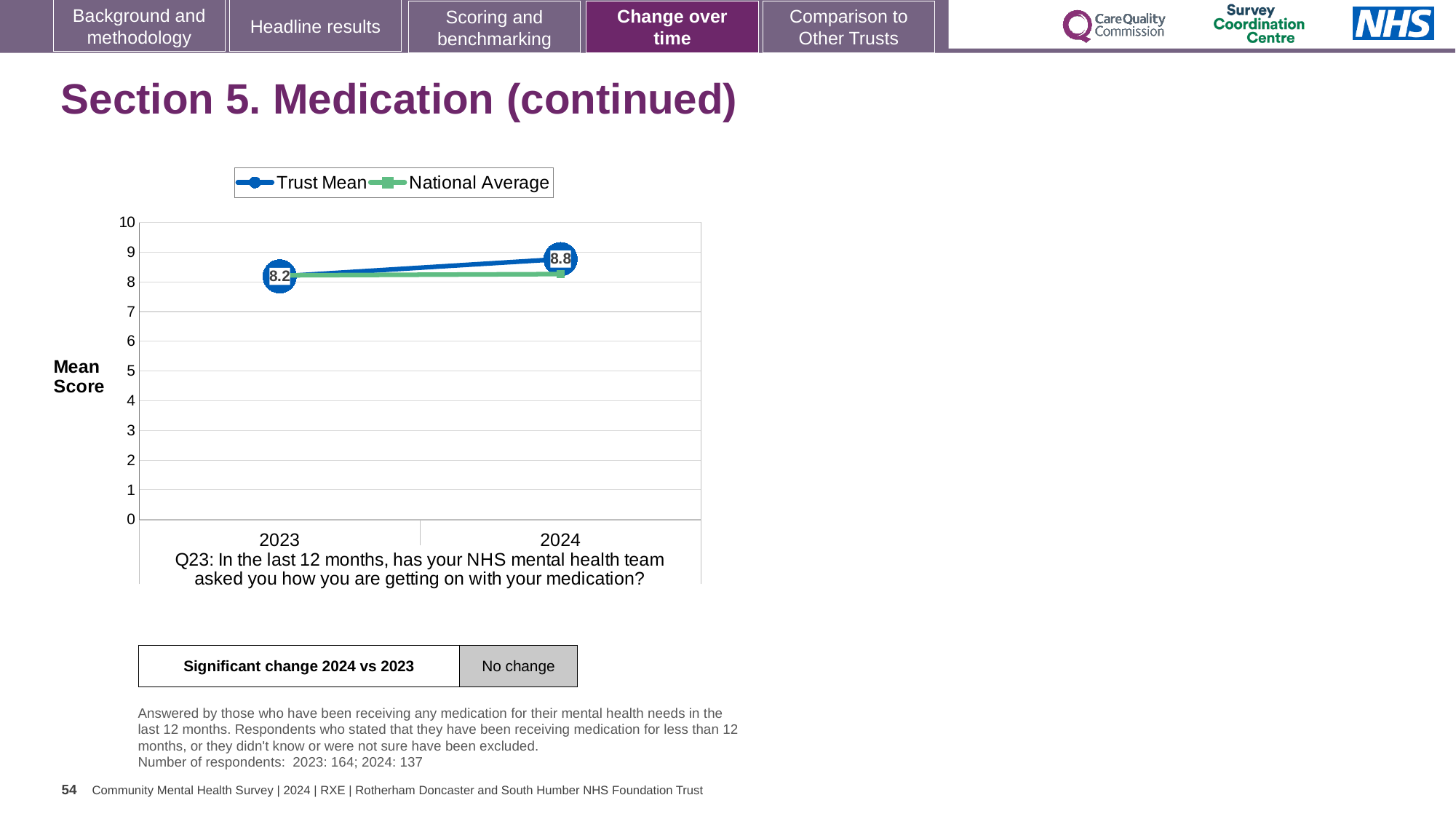
Is the National Average value for 2024 greater or less than 9? less In which year is the Trust Mean higher? 2024 Is the National Average value for 2024 greater or less than 8? greater What is the Trust Mean value for 2023? 8.2 What is the label on the y axis of the chart? Mean Score How many series does the legend list? 2 What kind of chart is shown on the slide? line chart Does the Trust Mean rise or fall from 2023 to 2024? rise What is the Trust Mean value for 2024? 8.8 In 2024, which is larger: the Trust Mean or the National Average? Trust Mean By how much did the Trust Mean change from 2023 to 2024? 0.6 How many years are plotted on the x axis? 2